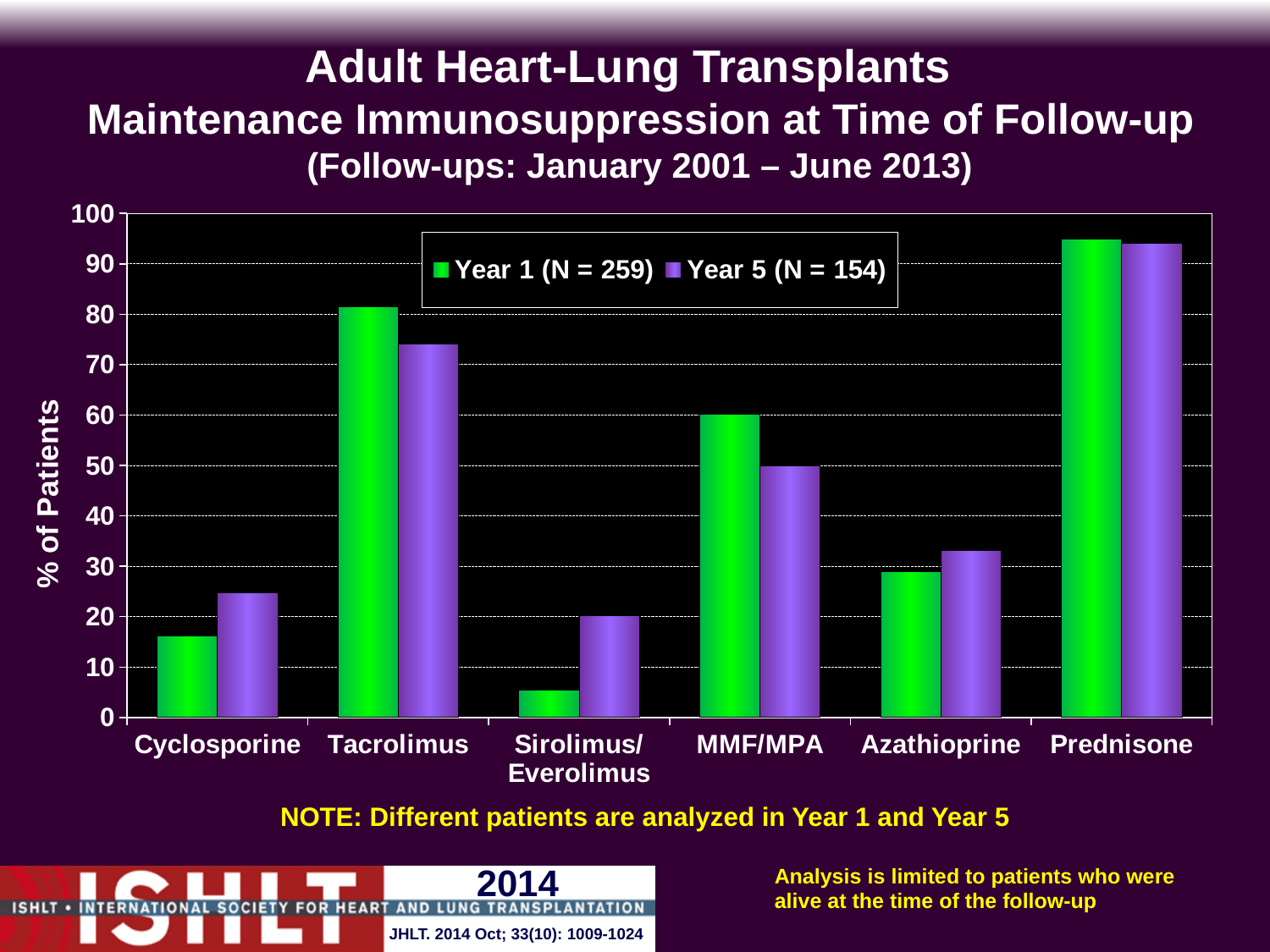
For MMF/MPA, which is larger: the Year 1 value or the Year 5 value? Year 1 Is the Year 5 value for Cyclosporine greater or less than 20? greater Is the Year 1 value for Sirolimus/Everolimus greater or less than 10? less How many series does the legend list? 2 Which drug has the highest Year 1 percentage of patients? Prednisone Which drug has the highest Year 5 percentage of patients? Prednisone What kind of chart is shown on the slide? bar chart What is the N for the Year 5 series shown in the legend? 154 For Azathioprine, which is larger: the Year 1 value or the Year 5 value? Year 5 Is the Year 1 value for Tacrolimus greater or less than 80? greater How many drug categories are shown on the x axis? 6 Which drug has the lowest Year 1 percentage of patients? Sirolimus/Everolimus